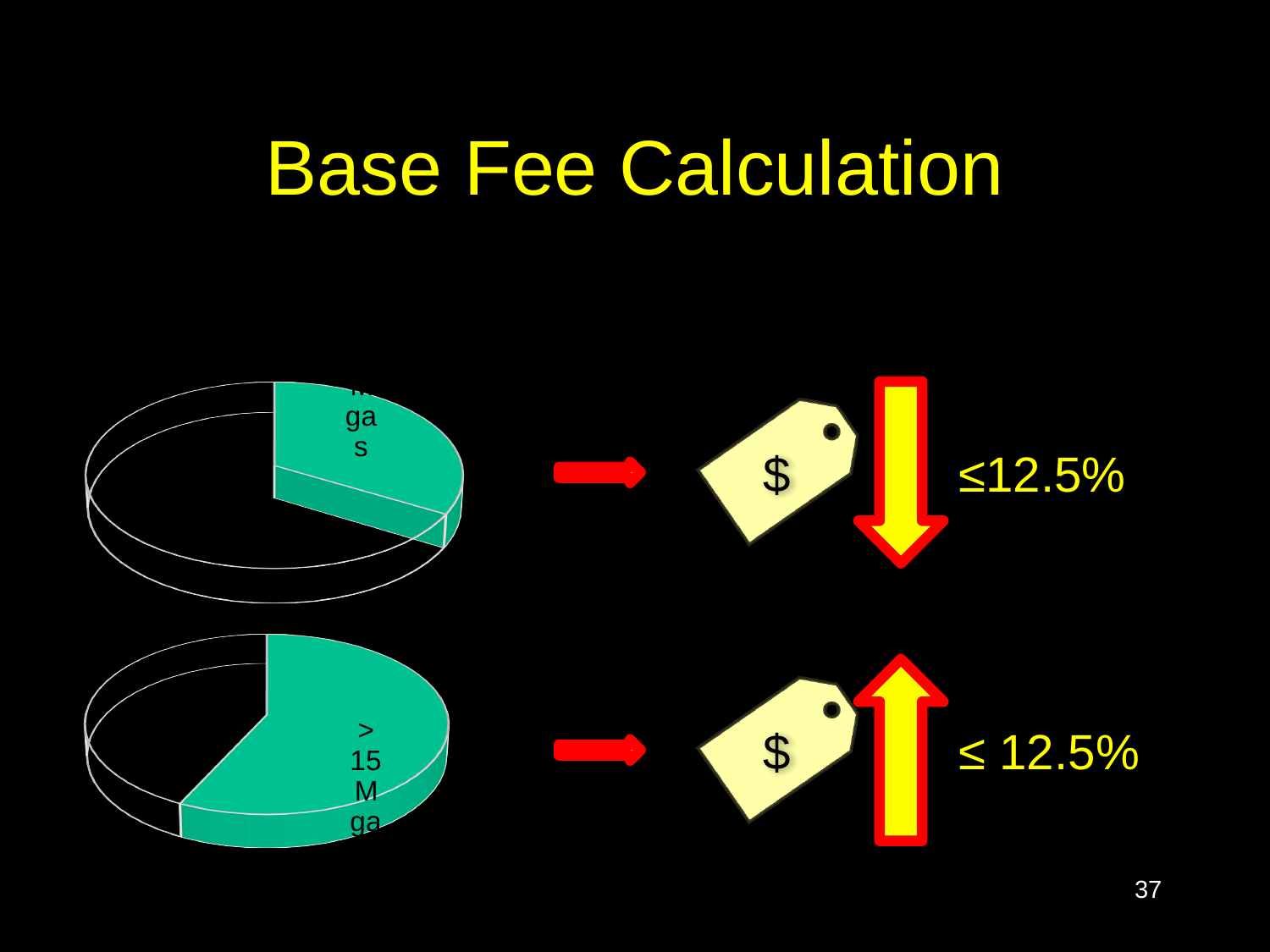
What kind of chart is the bottom chart on the left of the slide? pie chart What colour is the filled slice in each pie chart? green Which pie chart has the larger green slice, the top one or the bottom one? the bottom one How many pie charts are shown on the slide? 2 In the bottom pie chart, what is the label on the green slice? > 15 M gas What kind of chart is the top chart on the left of the slide? pie chart In the bottom pie chart, is the green slice more or less than half of the pie? more In the top pie chart, is the green slice more or less than half of the pie? less